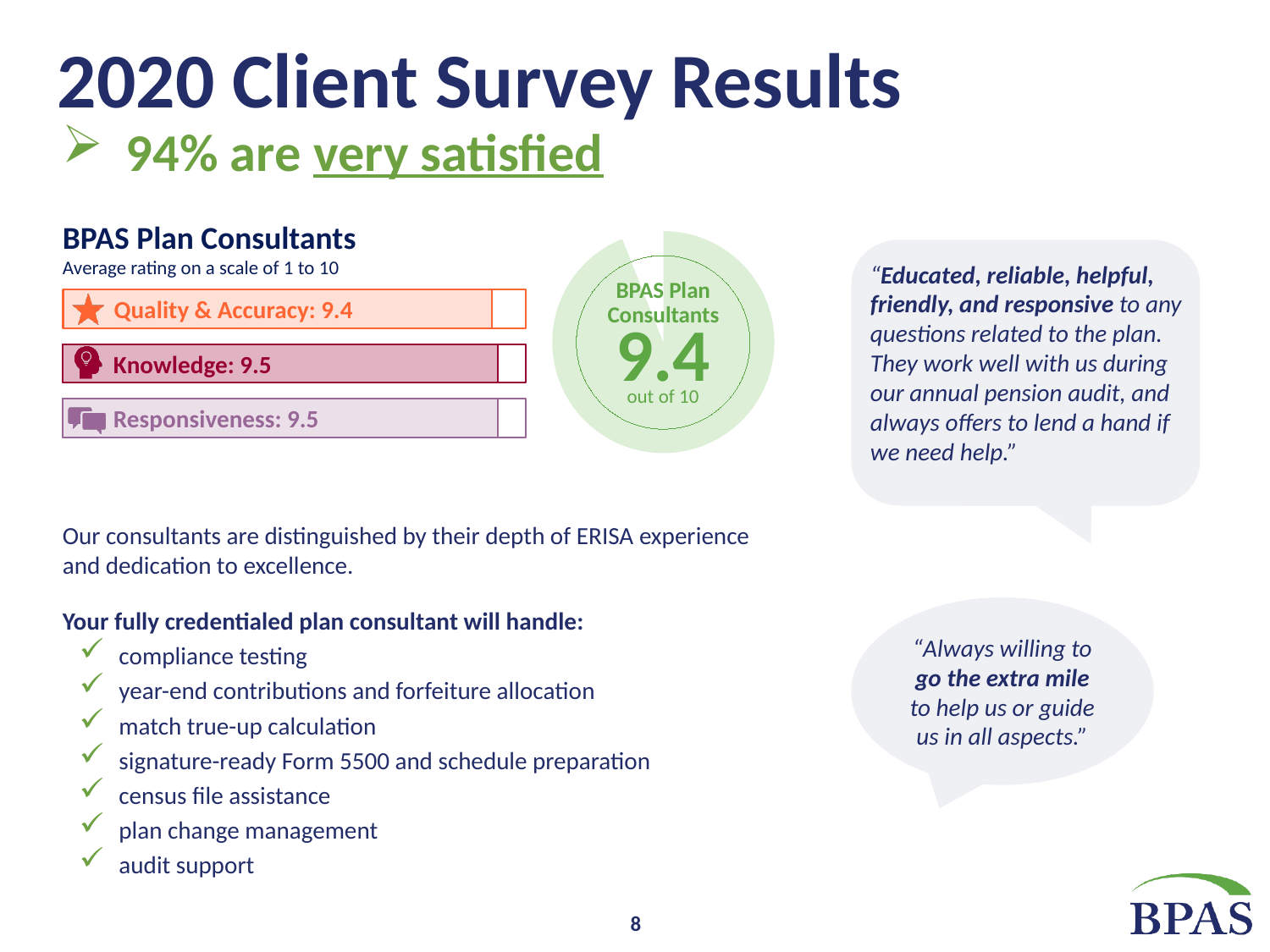
In the BPAS Plan Consultants bar chart, which is rated higher, Knowledge or Quality & Accuracy? Knowledge In the BPAS Plan Consultants bar chart, is the Knowledge rating greater or less than 9? greater In the BPAS Plan Consultants bar chart, what is the average rating for Quality & Accuracy? 9.4 What overall rating is shown in the green circular chart for BPAS Plan Consultants? 9.4 out of 10 What kind of chart is used to show the BPAS Plan Consultants ratings for Quality & Accuracy, Knowledge and Responsiveness? Bar chart In the BPAS Plan Consultants bar chart, what is the average rating for Knowledge? 9.5 In the BPAS Plan Consultants bar chart, which category has the lowest average rating? Quality & Accuracy How many categories are shown in the BPAS Plan Consultants bar chart? 3 What rating scale is used for the BPAS Plan Consultants bar chart? A scale of 1 to 10 In the BPAS Plan Consultants bar chart, what is the average rating for Responsiveness? 9.5 What colour is the Quality & Accuracy bar in the BPAS Plan Consultants bar chart? Orange In the BPAS Plan Consultants bar chart, what is the difference between the Responsiveness rating and the Quality & Accuracy rating? 0.1